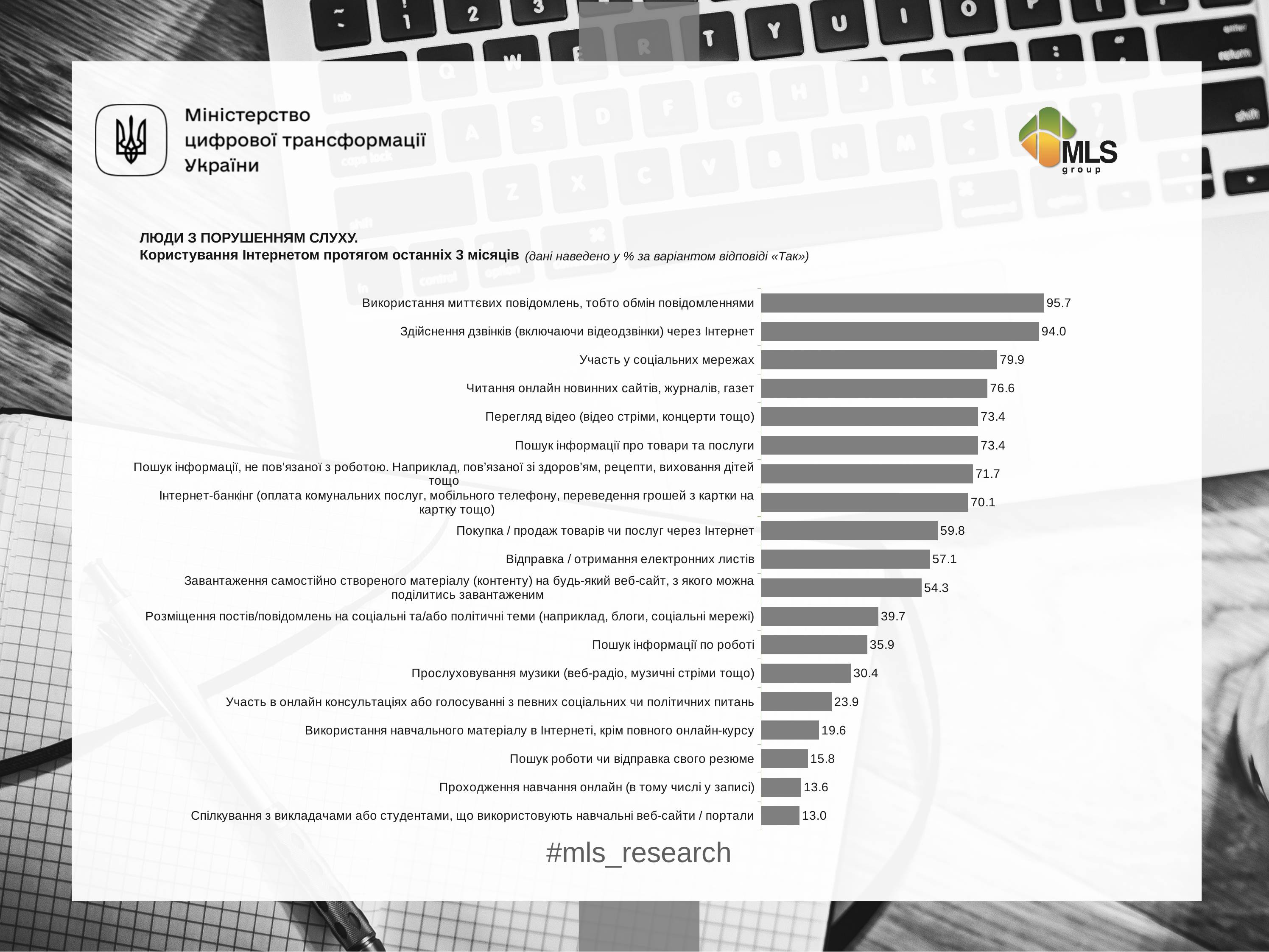
What hashtag is shown below the chart? #mls_research What is the value for "Участь у соціальних мережах"? 79.9 What is the value for "Проходження навчання онлайн (в тому числі у записі)"? 13.6 Which is larger: the value for "Пошук інформації по роботі" or the value for "Прослуховування музики (веб-радіо, музичні стріми тощо)"? Пошук інформації по роботі What kind of chart is shown on the slide? Bar chart How many categories are shown in the chart? 19 Which category has the highest value? Використання миттєвих повідомлень, тобто обмін повідомленнями What is the value for "Покупка / продаж товарів чи послуг через Інтернет"? 59.8 Which category has the lowest value? Спілкування з викладачами або студентами, що використовують навчальні веб-сайти / портали What is the value for "Пошук роботи чи відправка свого резюме"? 15.8 What is the difference between the values for "Читання онлайн новинних сайтів, журналів, газет" and "Перегляд відео (відео стріми, концерти тощо)"? 3.2 What is the difference between the values for "Здійснення дзвінків (включаючи відеодзвінки) через Інтернет" and "Відправка / отримання електронних листів"? 36.9